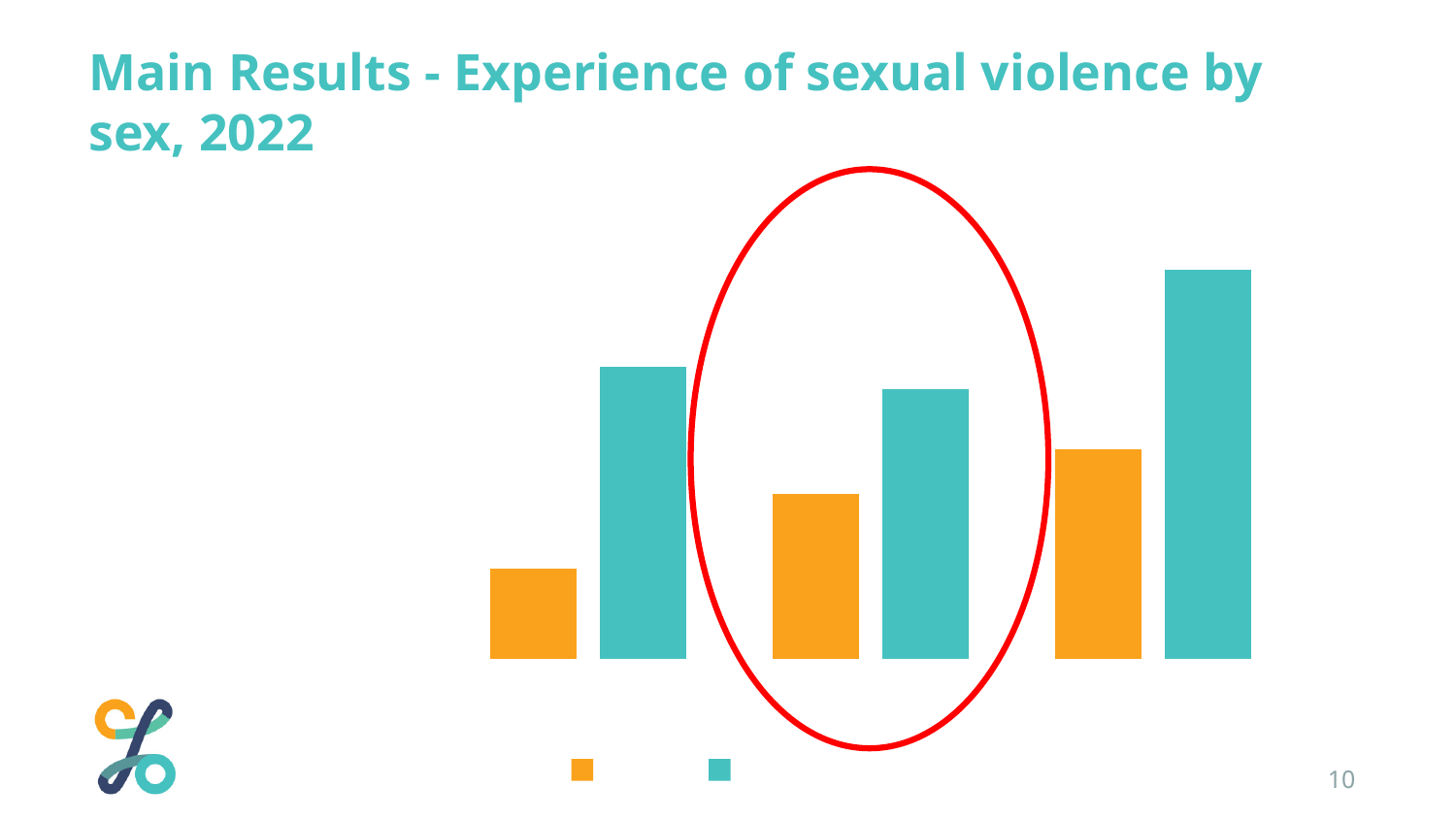
Which group of bars contains the tallest bar in the chart? the rightmost group In the leftmost group of bars, which bar is taller, the orange one or the teal one? the teal one Do the orange bars rise or fall from left to right across the chart? rise What two colours are used for the bars in the chart? orange and teal In the rightmost group of bars, which bar is taller, the orange one or the teal one? the teal one Which group of bars contains the shortest bar in the chart? the leftmost group How many series does the legend list? 2 What kind of chart is shown on the slide? bar chart Which group of bars is circled in red on the slide? the middle group In the middle group of bars, which bar is taller, the orange one or the teal one? the teal one How many groups of bars does the chart show? 3